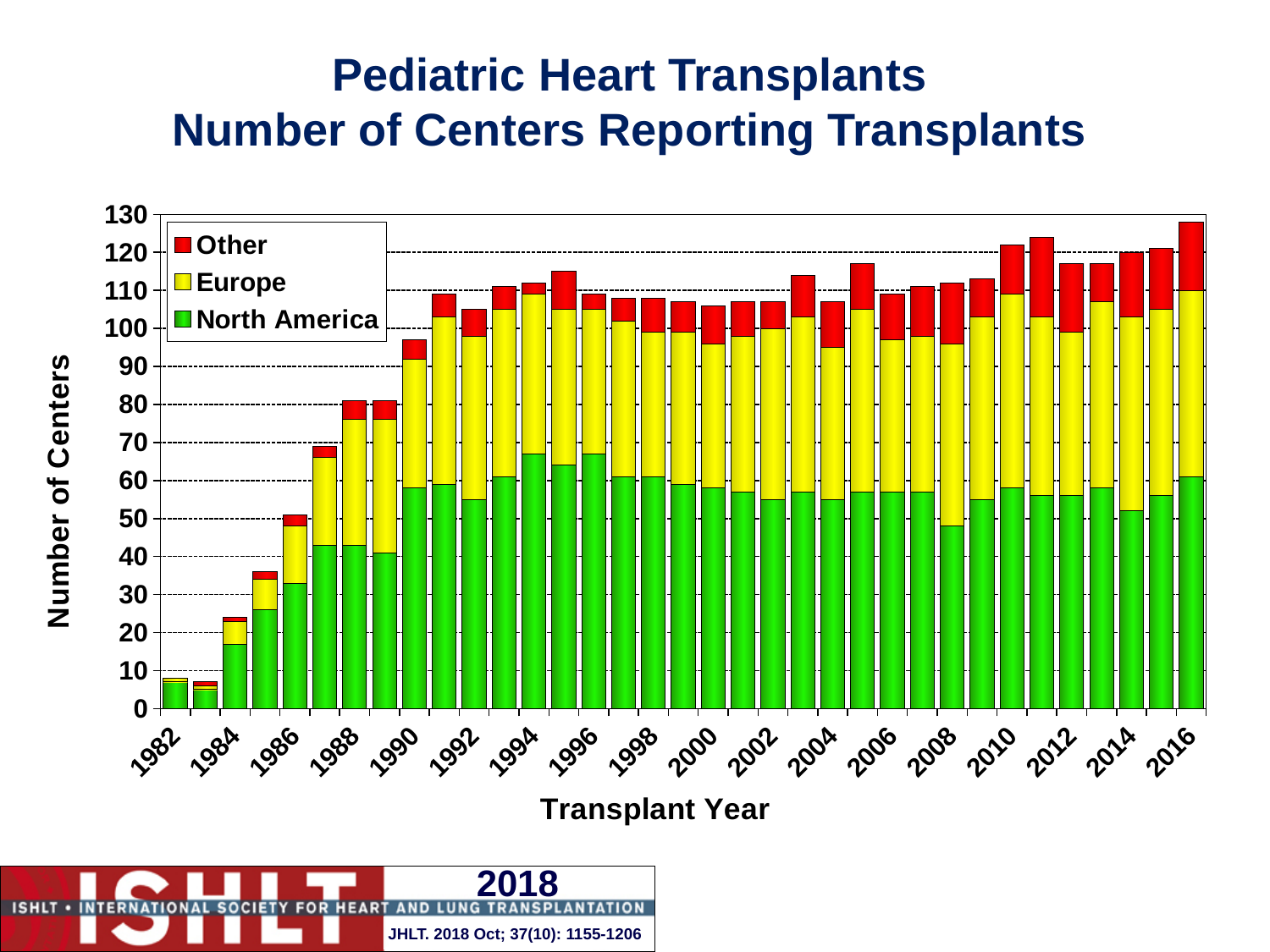
Is the total number of centers for 1985 greater or less than 30? greater How many series does the legend list? 3 Is the total number of centers for 2016 greater or less than 120? greater Does the total number of centers rise or fall from 1982 to 1990? rise What colour represents North America in the chart? green What kind of chart is shown on the slide? stacked bar chart Which transplant year has the highest total number of centers? 2016 Which series are listed in the legend? Other, Europe, North America Which year has a larger total number of centers, 1990 or 2000? 2000 Is the total number of centers for 1982 greater or less than 10? less How many transplant years (bars) are plotted in the chart? 35